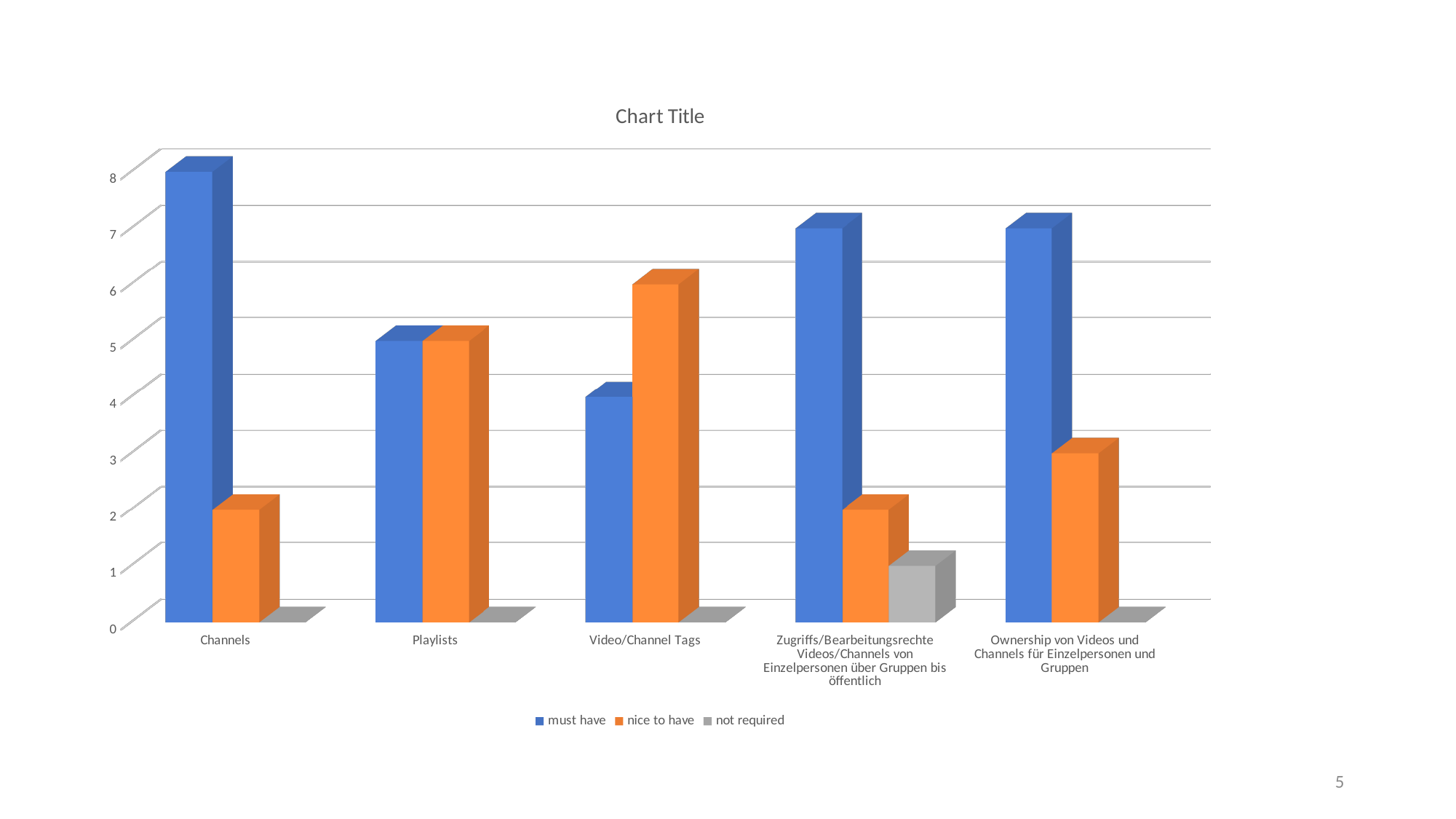
How many series does the legend list? 3 Which category has the highest 'nice to have' value? Video/Channel Tags How many categories are shown on the x axis? 5 Which category has the highest 'must have' value? Channels What is the title of the chart? Chart Title Is the 'nice to have' value for Channels greater or less than 4? less What kind of chart is shown on the slide? bar chart What is the 'must have' value for Channels? 8 Is the 'must have' value for Channels greater or less than 6? greater Which category has the lowest 'must have' value? Video/Channel Tags For Video/Channel Tags, which is larger: 'must have' or 'nice to have'? nice to have Is the 'nice to have' value for Ownership von Videos und Channels für Einzelpersonen und Gruppen greater or less than 5? less